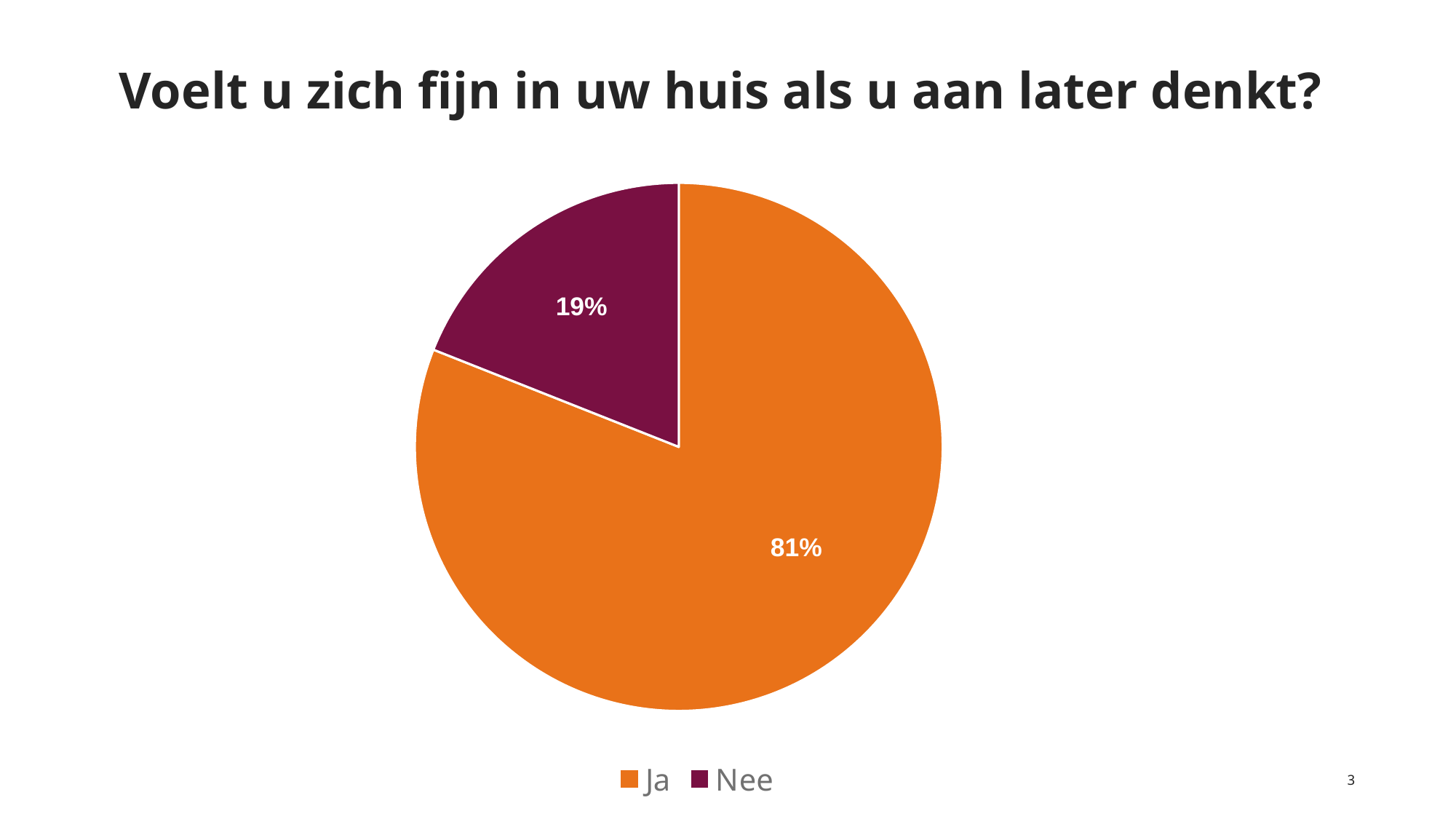
What is the title of the chart on the slide? Voelt u zich fijn in uw huis als u aan later denkt? What percentage of the pie chart is labelled "Ja"? 81% Which slice of the pie chart is the largest? Ja What share of the pie does the "Nee" slice represent? 19% Which slice of the pie chart is the smallest? Nee How many entries does the legend list? 2 What is the difference in percentage points between the "Ja" and "Nee" slices? 62 What percentage of the pie chart is labelled "Nee"? 19% Which slice is larger, "Ja" or "Nee"? Ja How many slices does the pie chart have? 2 What kind of chart is shown on the slide? Pie chart What colour is the "Ja" slice in the pie chart? Orange